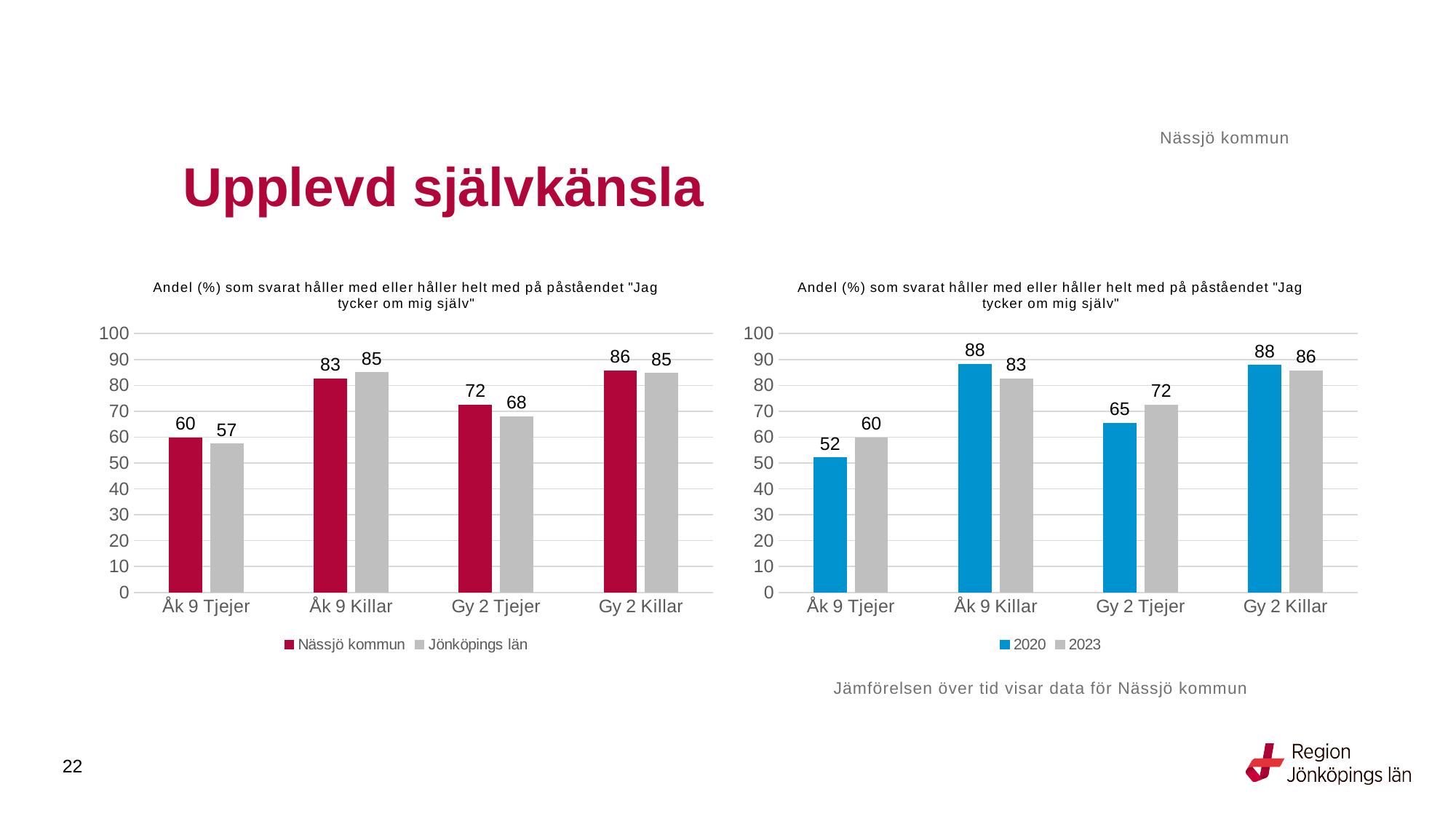
In the right chart, what is the value for 2023 for Gy 2 Tjejer? 72 In the left chart, what is the difference between Nässjö kommun and Jönköpings län for Gy 2 Tjejer? 4 In the right chart, what is the value for 2020 for Åk 9 Tjejer? 52 In the left chart, what is the value for Nässjö kommun for Åk 9 Tjejer? 60 In the left chart, what is the value for Jönköpings län for Gy 2 Tjejer? 68 In the right chart, which category has the lowest value for 2020? Åk 9 Tjejer How many series does the legend of the right chart list? 2 What type of chart is the left chart? Bar chart In the right chart, what is the difference between 2023 and 2020 for Åk 9 Tjejer? 8 In the left chart, which category has the highest value for Nässjö kommun? Gy 2 Killar How many categories are shown on the x axis of the left chart? 4 In the right chart, which is larger for Åk 9 Killar: 2020 or 2023? 2020